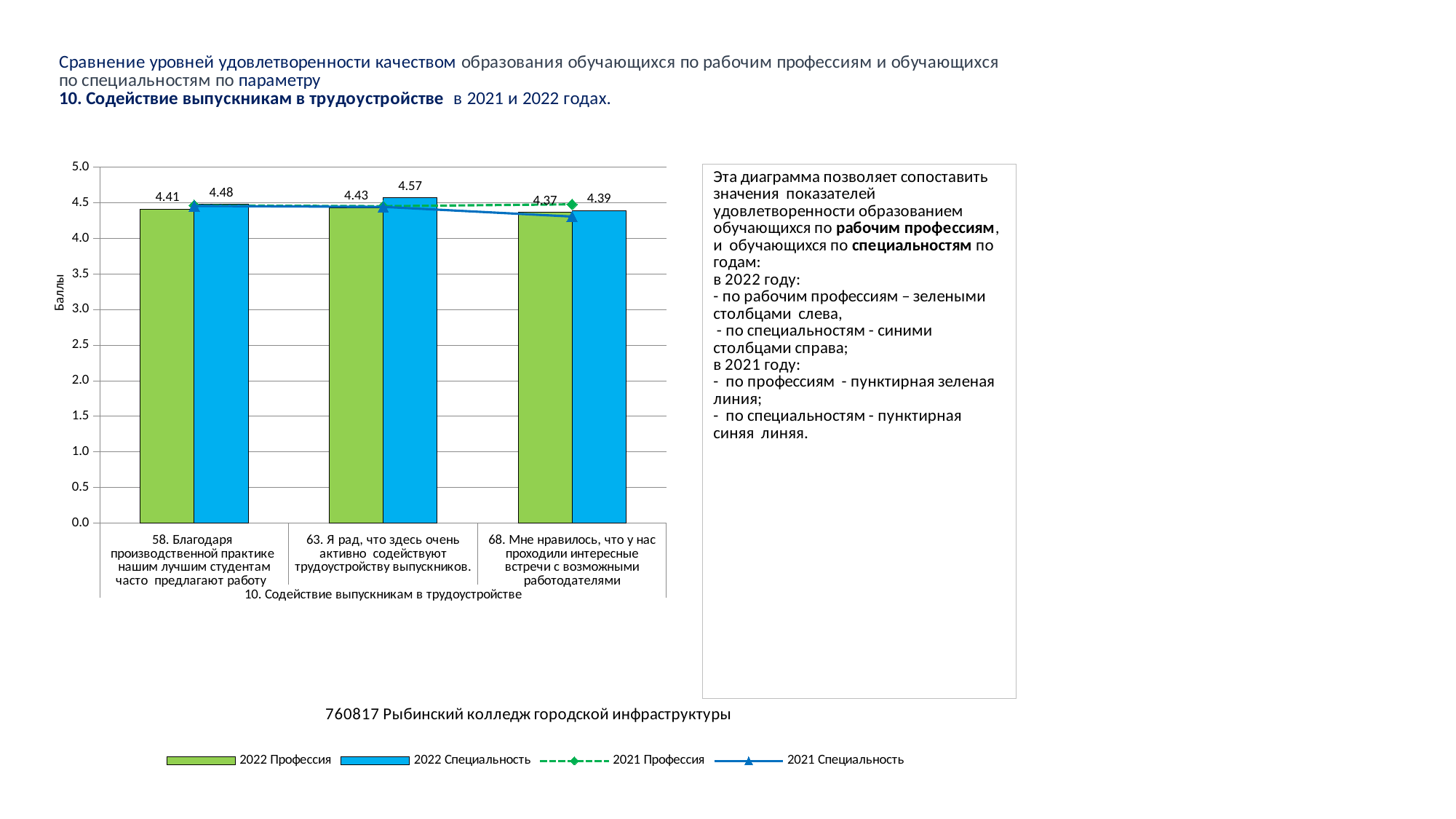
For category 58, which is larger: the 2022 Профессия bar or the 2022 Специальность bar? 2022 Специальность Is the 2021 Специальность value for category 68 greater or less than 4.5? less How many categories are shown on the x axis of the chart? 3 What is the value of the 2022 Профессия bar for category 63? 4.43 What is the title of the vertical axis of the chart? Баллы For category 63, what is the difference between the 2022 Специальность and 2022 Профессия values? 0.14 What is the value of the 2022 Специальность bar for category 63 (Я рад, что здесь очень активно содействуют трудоустройству выпускников)? 4.57 What is the value of the 2022 Профессия bar for category 58 (Благодаря производственной практике нашим лучшим студентам часто предлагают работу)? 4.41 What is the value of the 2022 Специальность bar for category 68 (Мне нравилось, что у нас проходили интересные встречи с возможными работодателями)? 4.39 How many series does the chart legend list? 4 Which category has the highest 2022 Специальность value? 63. Я рад, что здесь очень активно содействуют трудоустройству выпускников. Which category has the lowest 2022 Профессия value? 68. Мне нравилось, что у нас проходили интересные встречи с возможными работодателями